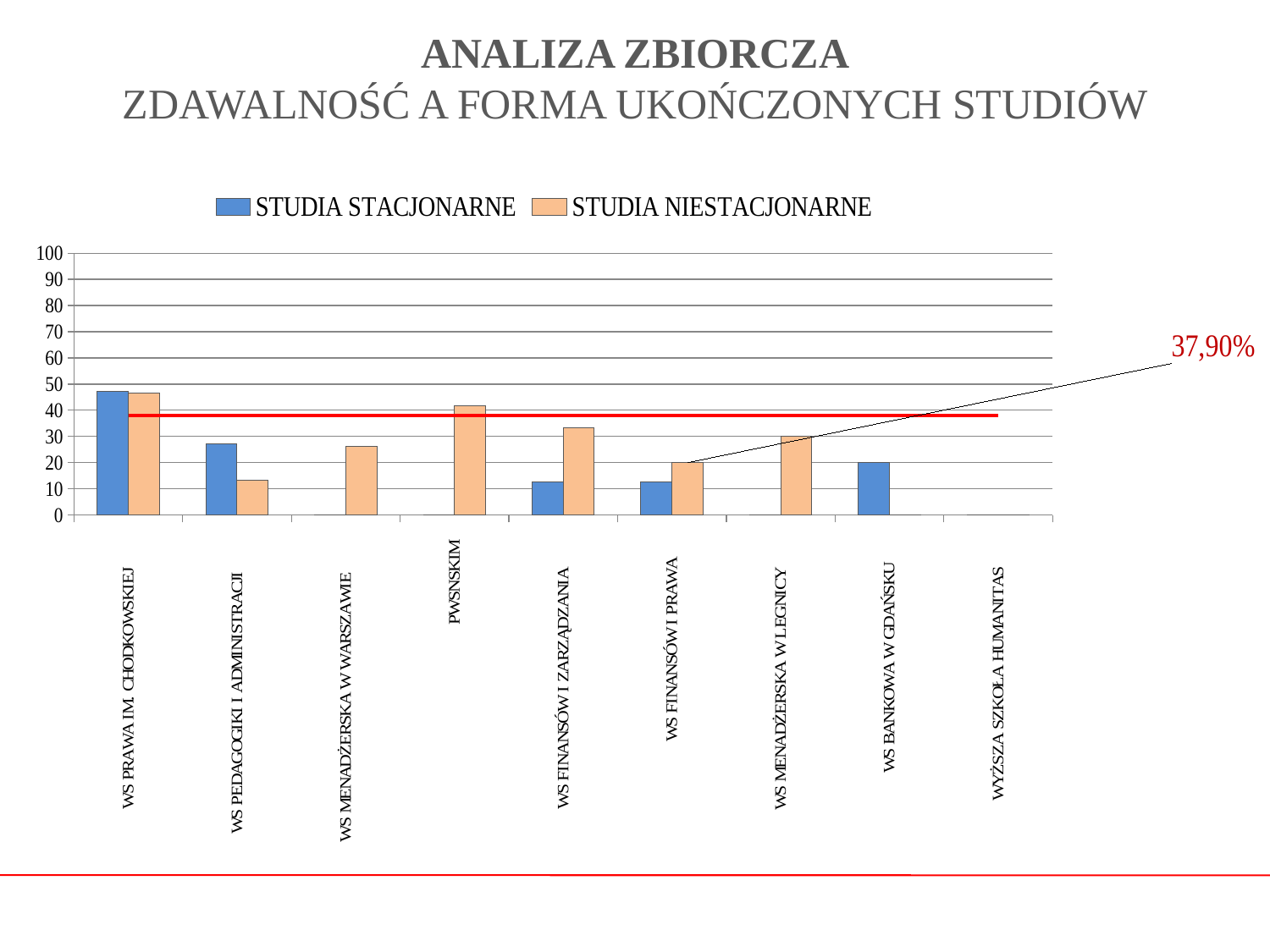
Is the STUDIA NIESTACJONARNE value for PWSNSKIM greater or less than 30? greater Which series is shown in blue in the legend? STUDIA STACJONARNE What value is labelled on the red horizontal line across the chart? 37,90% For WS PEDAGOGIKI I ADMINISTRACJI, which is larger: STUDIA STACJONARNE or STUDIA NIESTACJONARNE? STUDIA STACJONARNE How many series does the legend list? 2 For WS FINANSÓW I ZARZĄDZANIA, which is larger: STUDIA STACJONARNE or STUDIA NIESTACJONARNE? STUDIA NIESTACJONARNE Is the STUDIA STACJONARNE value for WS PRAWA IM. CHODKOWSKIEJ greater or less than 40? greater Which category has the highest STUDIA STACJONARNE value? WS PRAWA IM. CHODKOWSKIEJ Which category has the lowest STUDIA NIESTACJONARNE value among those with a visible orange bar? WS PEDAGOGIKI I ADMINISTRACJI How many categories (schools) are shown on the x axis? 9 What kind of chart is shown on the slide? bar chart Is the STUDIA STACJONARNE value for WS FINANSÓW I ZARZĄDZANIA greater or less than 20? less